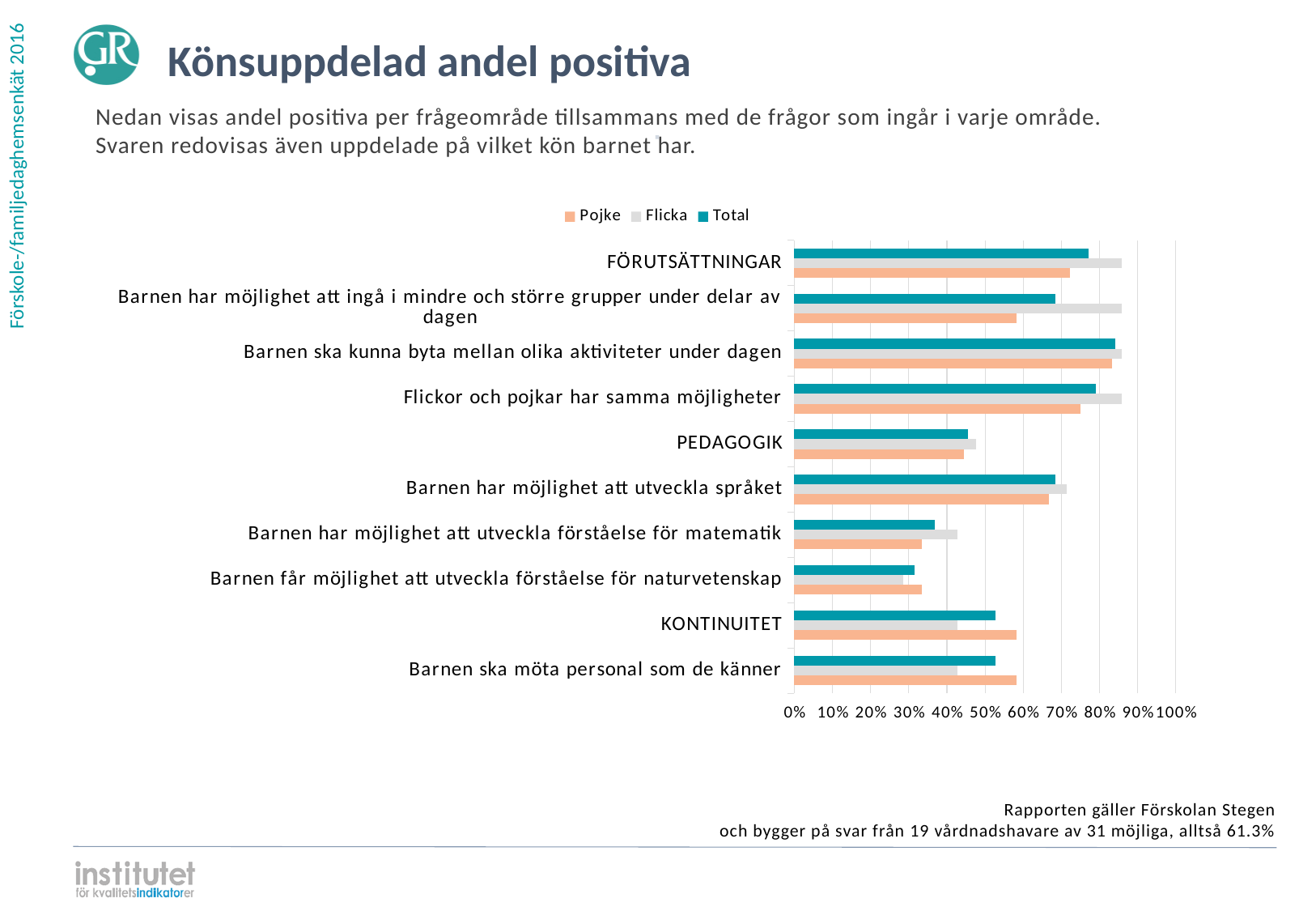
Which category has the highest Total value? Barnen ska kunna byta mellan olika aktiviteter under dagen For KONTINUITET, which is larger: the Pojke value or the Flicka value? Pojke How many categories are plotted on the vertical axis of the chart? 10 For 'Barnen har möjlighet att utveckla förståelse för matematik', which is larger: the Flicka value or the Pojke value? Flicka Is the Total value for 'Barnen får möjlighet att utveckla förståelse för naturvetenskap' greater or less than 40%? less Which series is shown in orange in the legend? Pojke Is the Flicka value for FÖRUTSÄTTNINGAR greater or less than 80%? greater Is the Total value for PEDAGOGIK greater or less than 50%? less What kind of chart is shown on the slide? bar chart How many series does the legend list? 3 Which category has the lowest Flicka value? Barnen får möjlighet att utveckla förståelse för naturvetenskap